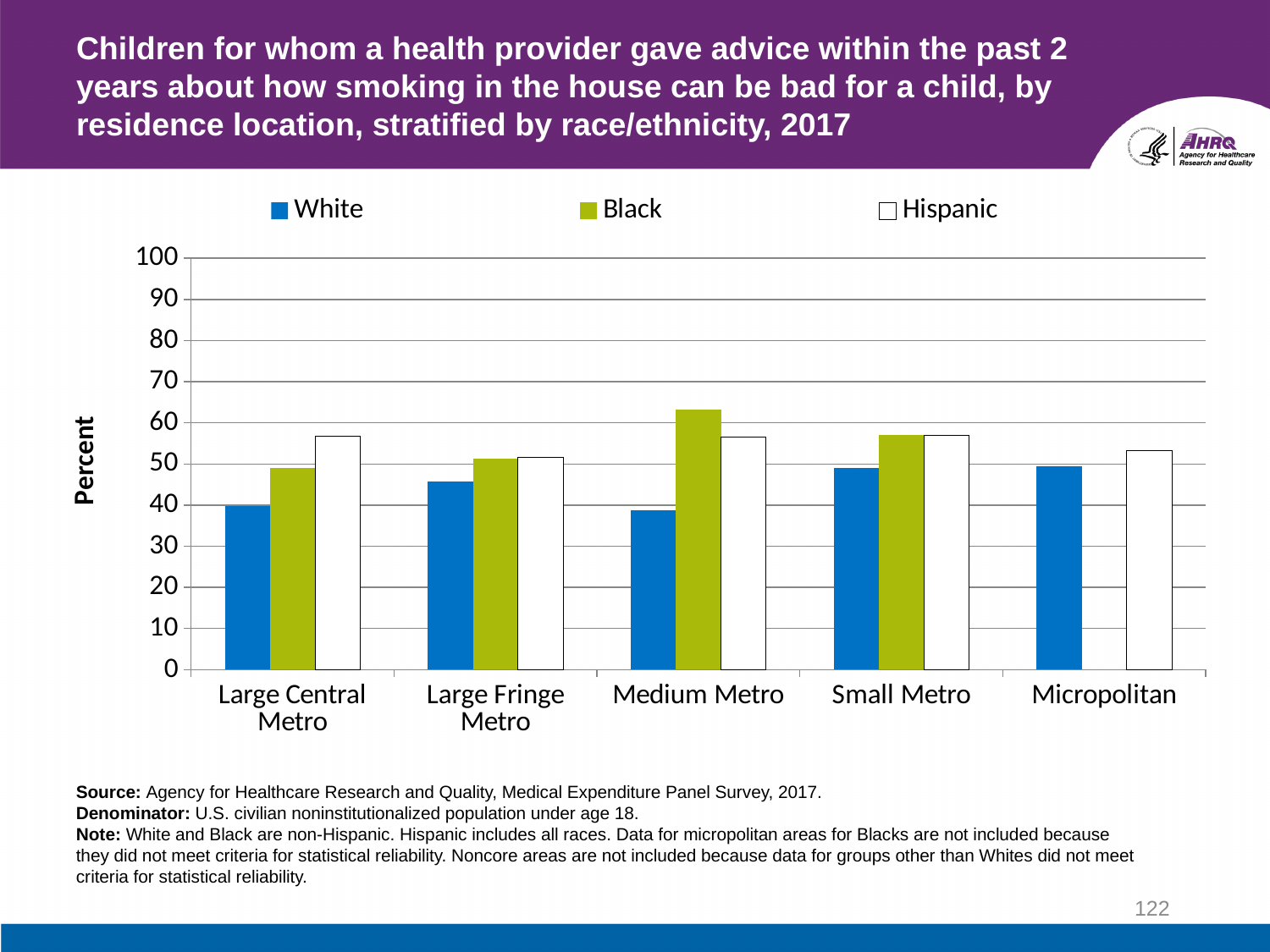
Which series and residence location has the tallest bar in the chart? Black, Medium Metro Which residence location has the highest value for Black? Medium Metro How many residence location categories are shown on the x axis? 5 How many series does the legend list? 3 In Medium Metro, which is larger, the value for Black or the value for White? Black Is the value for Black in Medium Metro greater or less than 60? greater What kind of chart is shown on the slide? bar chart In Large Central Metro, which is larger, the value for White or the value for Hispanic? Hispanic Is the value for White in Large Central Metro greater or less than 50? less Is the value for Hispanic in Micropolitan greater or less than 50? greater What is the label on the y axis? Percent Which residence location has no bar for Black? Micropolitan